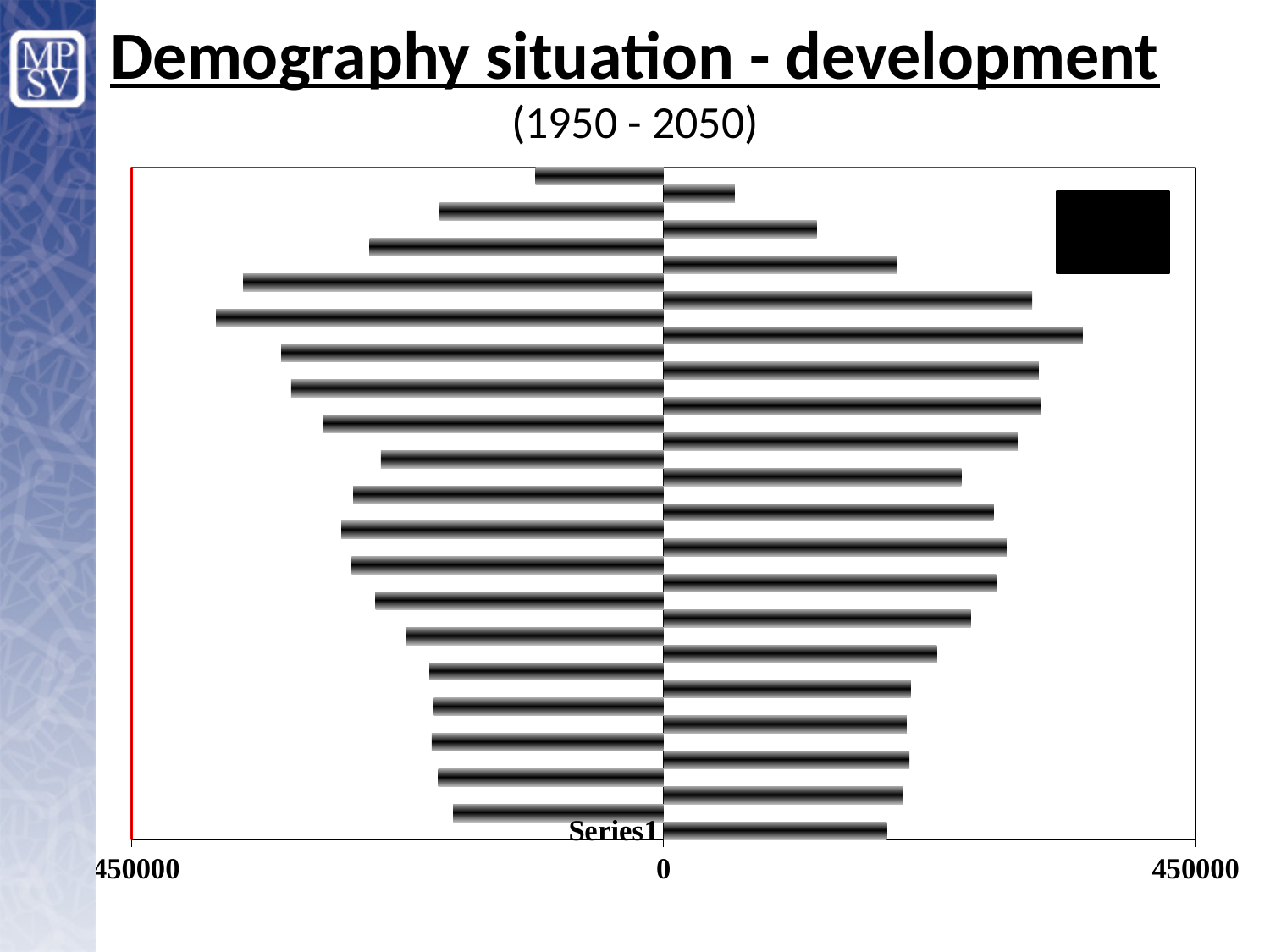
What kind of chart is shown on the slide? bar chart Is the longest bar extending to the right greater or less than 450000? less What series name is printed near the bottom centre of the chart? Series1 What is the value shown at the right end of the horizontal axis? 450000 What period is given in the slide subtitle below the chart title? 1950 - 2050 What value is shown at the centre of the horizontal axis, where the bars meet? 0 Are the bars in the chart horizontal or vertical? horizontal Is the longest bar extending to the left greater or less than 450000 in magnitude? less